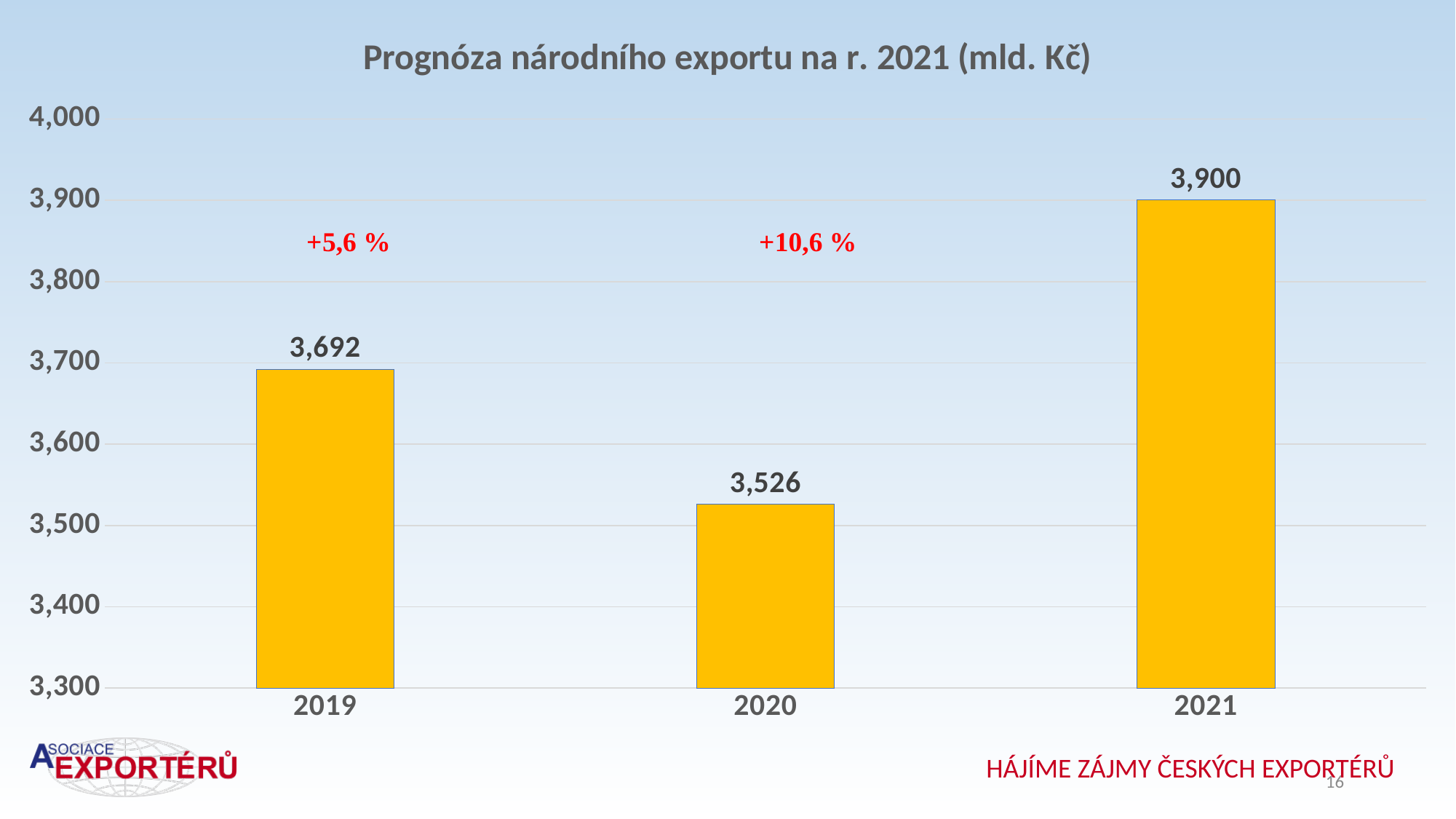
Is the value for 2020 greater or less than 3,600? less What kind of chart is shown on the slide? bar chart What is the difference between the values for 2019 and 2020? 166 What is the value for 2021? 3,900 What is the title of the chart? Prognóza národního exportu na r. 2021 (mld. Kč) How many years are shown on the x axis? 3 Which year has the highest value? 2021 What is the value for 2020? 3,526 What is the difference between the values for 2021 and 2020? 374 Which year has the lowest value? 2020 Which is larger, the value for 2019 or the value for 2021? 2021 What is the value for 2019? 3,692